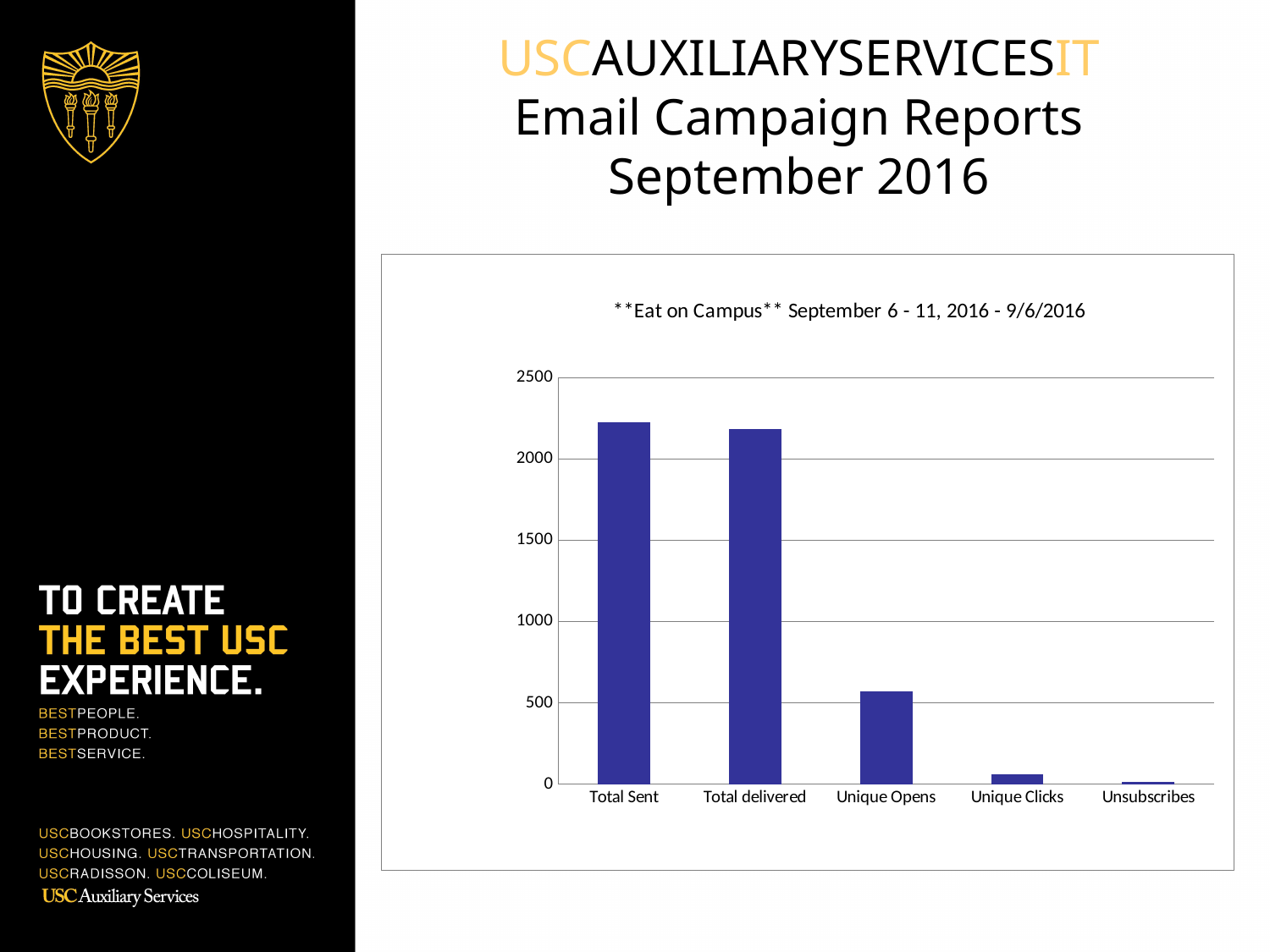
Which is larger, the value for Unique Opens or the value for Unique Clicks? Unique Opens Which category has the lowest value in the chart? Unsubscribes Is the value for Unique Opens greater or less than 1000? less Is the value for Unique Opens greater or less than 500? greater Do the values rise or fall moving from left to right along the x axis? fall Is the value for Unique Clicks greater or less than 500? less What is the title of the chart? **Eat on Campus** September 6 - 11, 2016 - 9/6/2016 What kind of chart is shown on the slide? bar chart How many categories are shown on the x axis of the chart? 5 Which is larger, the value for Total delivered or the value for Unique Opens? Total delivered